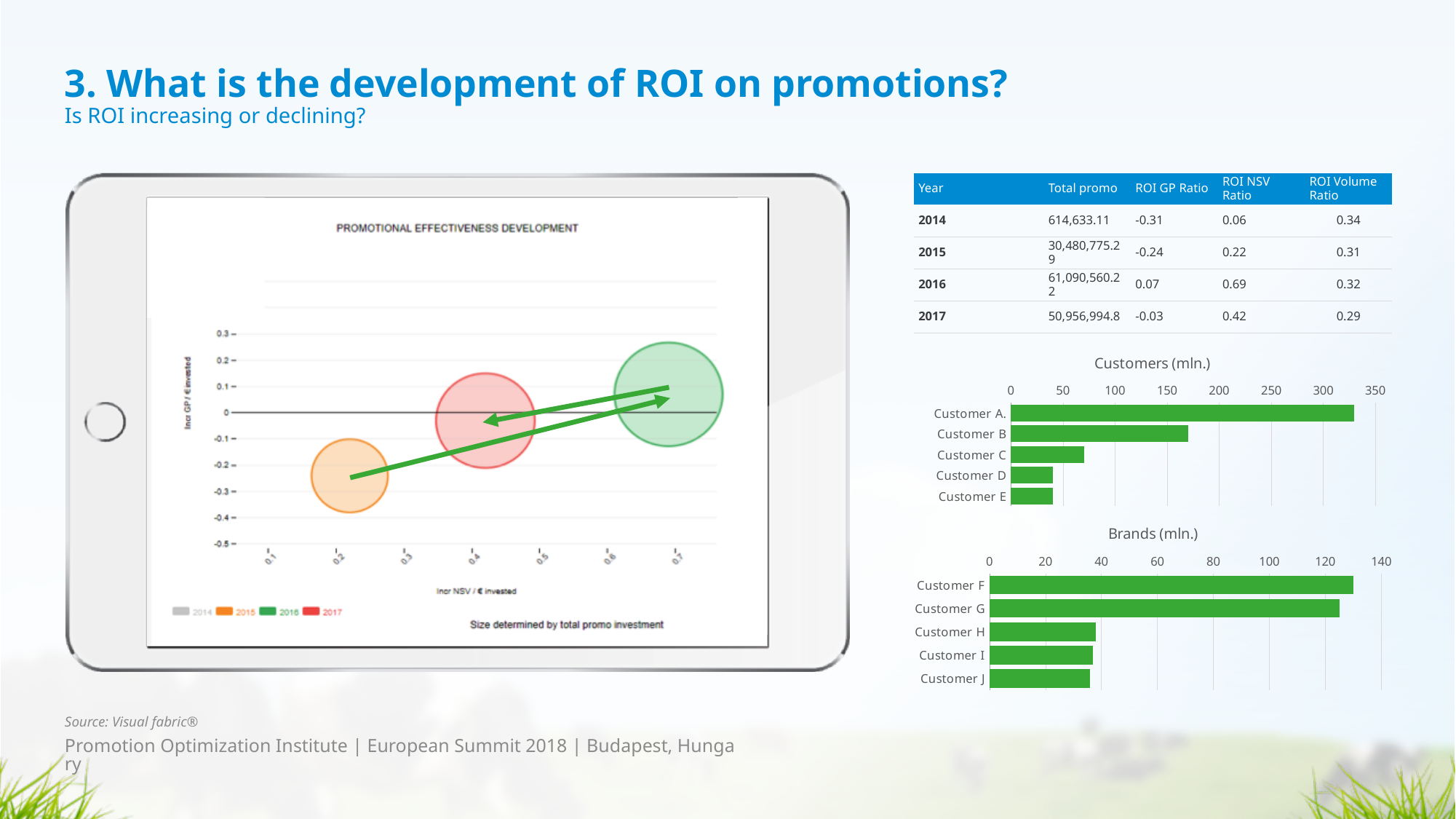
How many entries does the legend of the "Promotional Effectiveness Development" chart list? 4 In the "Brands (mln.)" chart, is the value for Customer F greater or less than 120? greater In the "Customers (mln.)" chart, which customer has the highest value? Customer A. How many customers are shown in the "Customers (mln.)" chart? 5 In the "Customers (mln.)" chart, is the value for Customer B greater or less than 150? greater In the "Brands (mln.)" chart, is the value for Customer H greater or less than 60? less What kind of chart is the "Customers (mln.)" chart? bar chart In the "Customers (mln.)" chart, which is larger, the value for Customer B or Customer C? Customer B How many categories are shown in the "Brands (mln.)" chart? 5 In the "Brands (mln.)" chart, which is larger, the value for Customer G or Customer J? Customer G